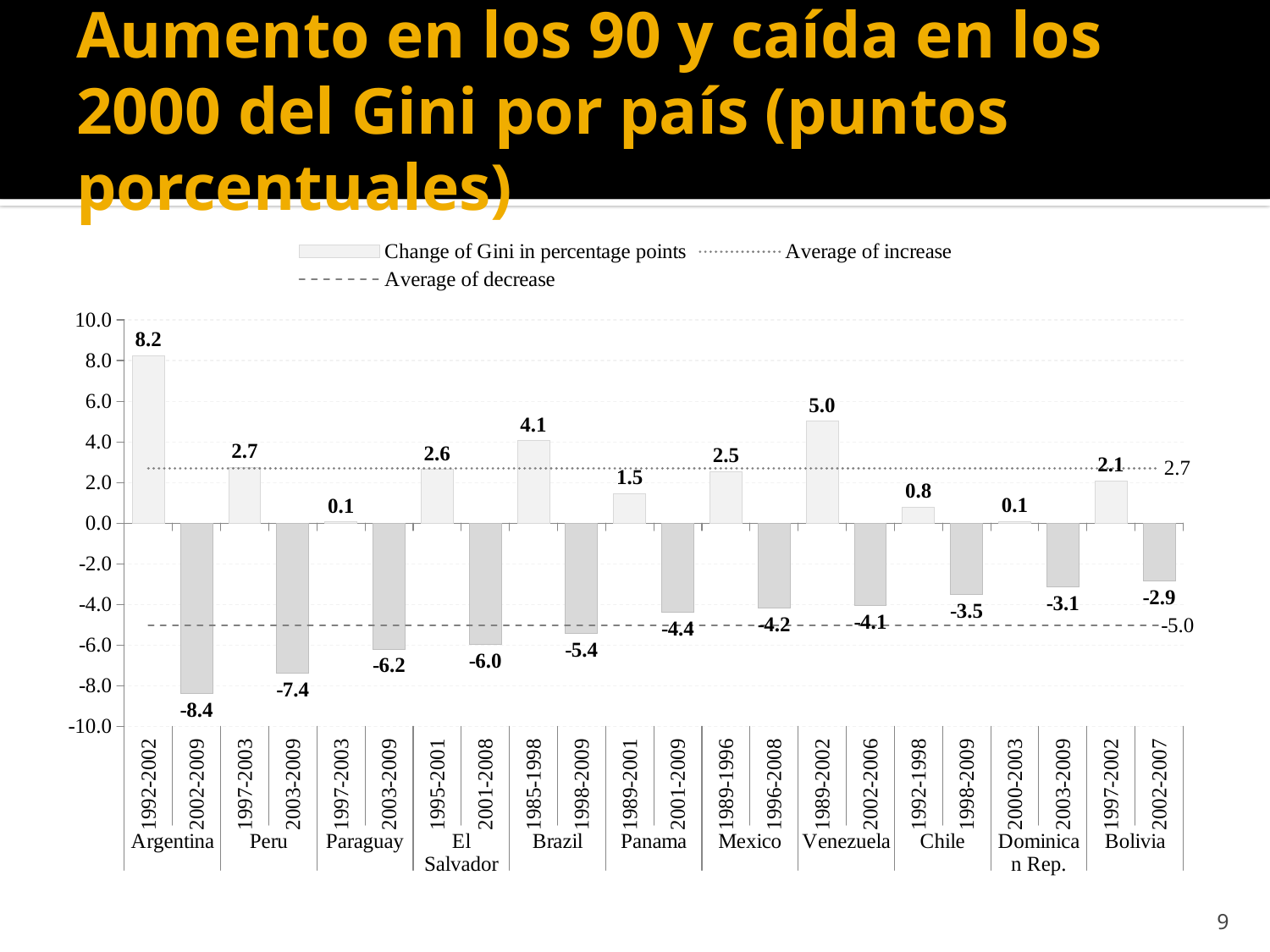
What is the difference between the Gini change for Peru in 1997-2003 and Peru in 2003-2009? 10.1 What value is shown for the average of decrease line? -5.0 How many countries are shown on the x axis? 11 What value is shown for the average of increase line? 2.7 Which is larger, the Gini increase for Brazil in 1985-1998 or for Mexico in 1989-1996? Brazil, 1985-1998 How many series does the legend list? 3 What is the change of Gini in percentage points for Argentina in 1992-2002? 8.2 What is the change of Gini in percentage points for Venezuela in 1989-2002? 5.0 Which country and period has the largest increase in the Gini? Argentina, 1992-2002 What kind of chart is shown on the slide? Combination bar and line chart (bars with two average lines) What is the change of Gini in percentage points for Brazil in 1998-2009? -5.4 Which country and period has the largest decrease in the Gini? Argentina, 2002-2009